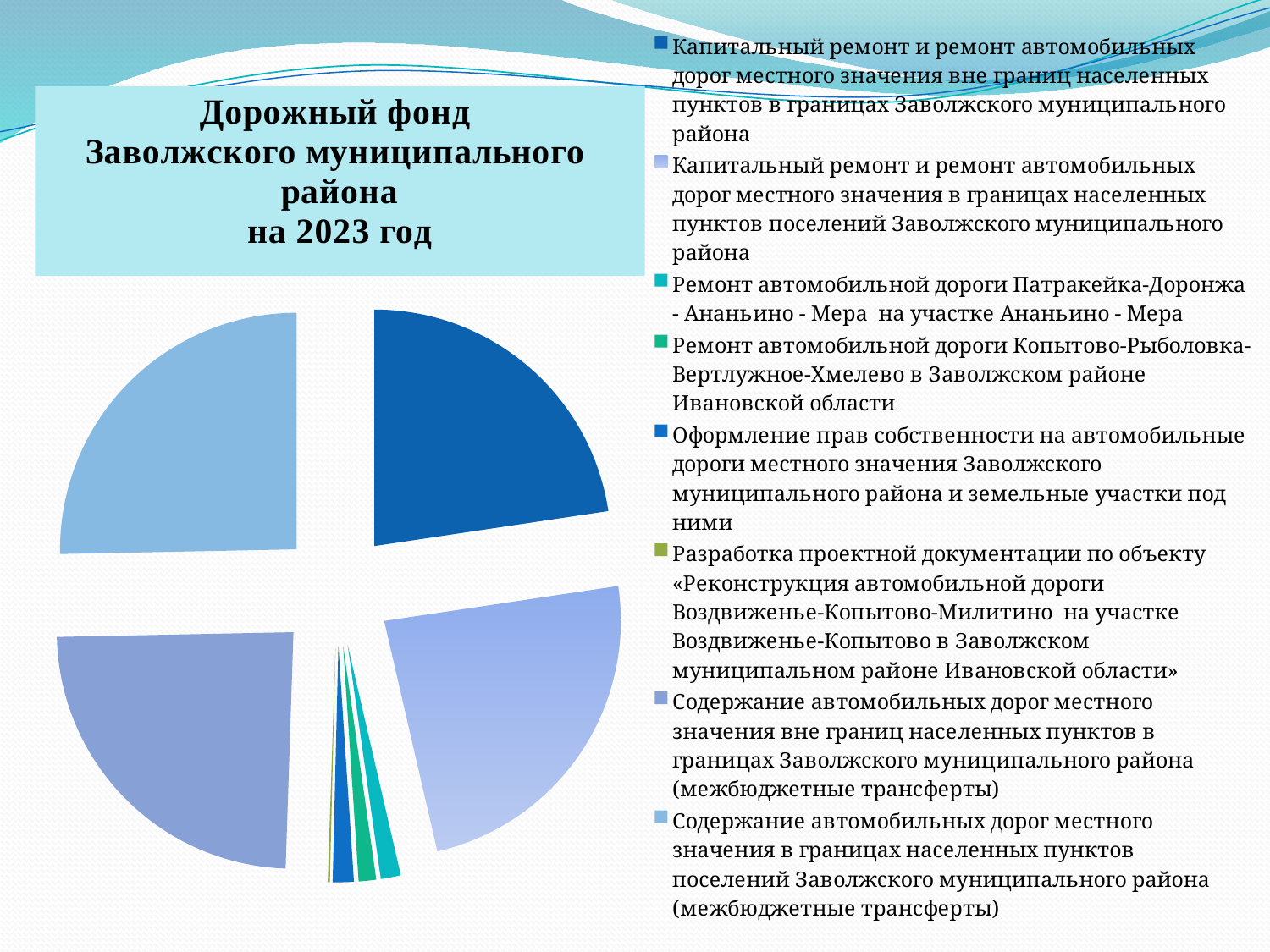
Does the pie chart display numeric data labels on its slices? No How many slices does the pie chart have? 8 What kind of chart is shown on the slide? Pie chart Which is larger: the slice for «Капитальный ремонт и ремонт автомобильных дорог местного значения вне границ населенных пунктов в границах Заволжского муниципального района» or the slice for «Ремонт автомобильной дороги Патракейка-Доронжа - Ананьино - Мера на участке Ананьино - Мера»? Капитальный ремонт и ремонт автомобильных дорог местного значения вне границ населенных пунктов в границах Заволжского муниципального района Which is larger: the slice for «Оформление прав собственности на автомобильные дороги местного значения Заволжского муниципального района и земельные участки под ними» or the slice for «Содержание автомобильных дорог местного значения вне границ населенных пунктов в границах Заволжского муниципального района (межбюджетные трансферты)»? Содержание автомобильных дорог местного значения вне границ населенных пунктов в границах Заволжского муниципального района (межбюджетные трансферты) How many entries does the legend of the pie chart list? 8 Which is larger: the slice for «Содержание автомобильных дорог местного значения в границах населенных пунктов поселений Заволжского муниципального района (межбюджетные трансферты)» or the slice for «Разработка проектной документации по объекту «Реконструкция автомобильной дороги Воздвиженье-Копытово-Милитино на участке Воздвиженье-Копытово в Заволжском муниципальном районе Ивановской области»»? Содержание автомобильных дорог местного значения в границах населенных пунктов поселений Заволжского муниципального района (межбюджетные трансферты) What is the title shown above the chart? Дорожный фонд Заволжского муниципального района на 2023 год Which legend entry is shown in the first (top) position of the legend? Капитальный ремонт и ремонт автомобильных дорог местного значения вне границ населенных пунктов в границах Заволжского муниципального района